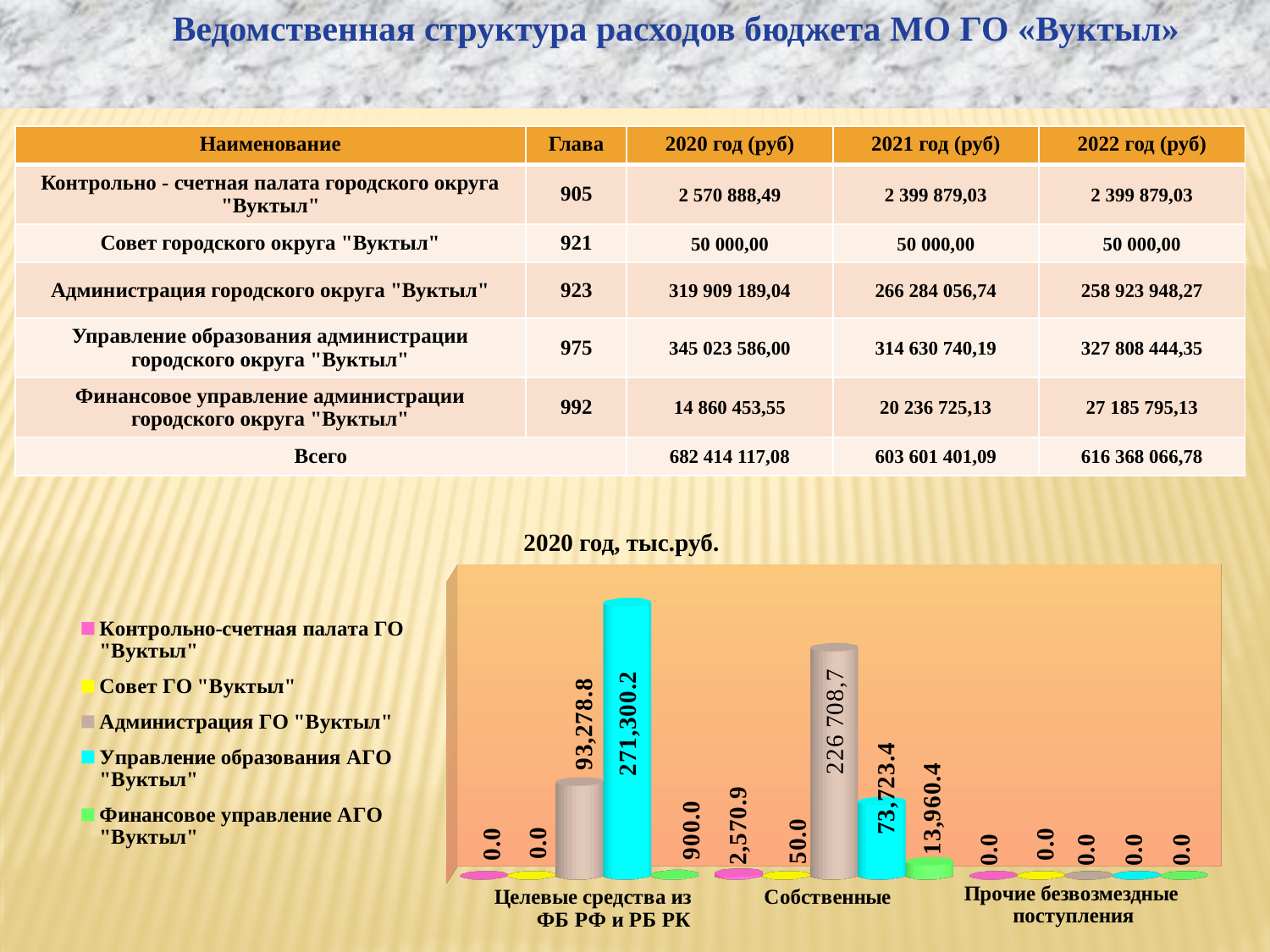
Which series has the highest value in the category Собственные? Администрация ГО "Вуктыл" What is the title of the chart? 2020 год, тыс.руб. What is the value for Управление образования АГО "Вуктыл" in the category Целевые средства из ФБ РФ и РБ РК? 271,300.2 Which series has the highest value in the category Целевые средства из ФБ РФ и РБ РК? Управление образования АГО "Вуктыл" How many series does the chart legend list? 5 What kind of chart is shown on the slide? bar chart What is the value for Финансовое управление АГО "Вуктыл" in the category Целевые средства из ФБ РФ и РБ РК? 900.0 What is the value for Контрольно-счетная палата ГО "Вуктыл" in the category Собственные? 2,570.9 How many categories are shown on the x axis of the chart? 3 Which is larger for Администрация ГО "Вуктыл": the value in Целевые средства из ФБ РФ и РБ РК or in Собственные? Собственные What is the value for Администрация ГО "Вуктыл" in the category Собственные? 226 708,7 What is the value for Финансовое управление АГО "Вуктыл" in the category Собственные? 13,960.4